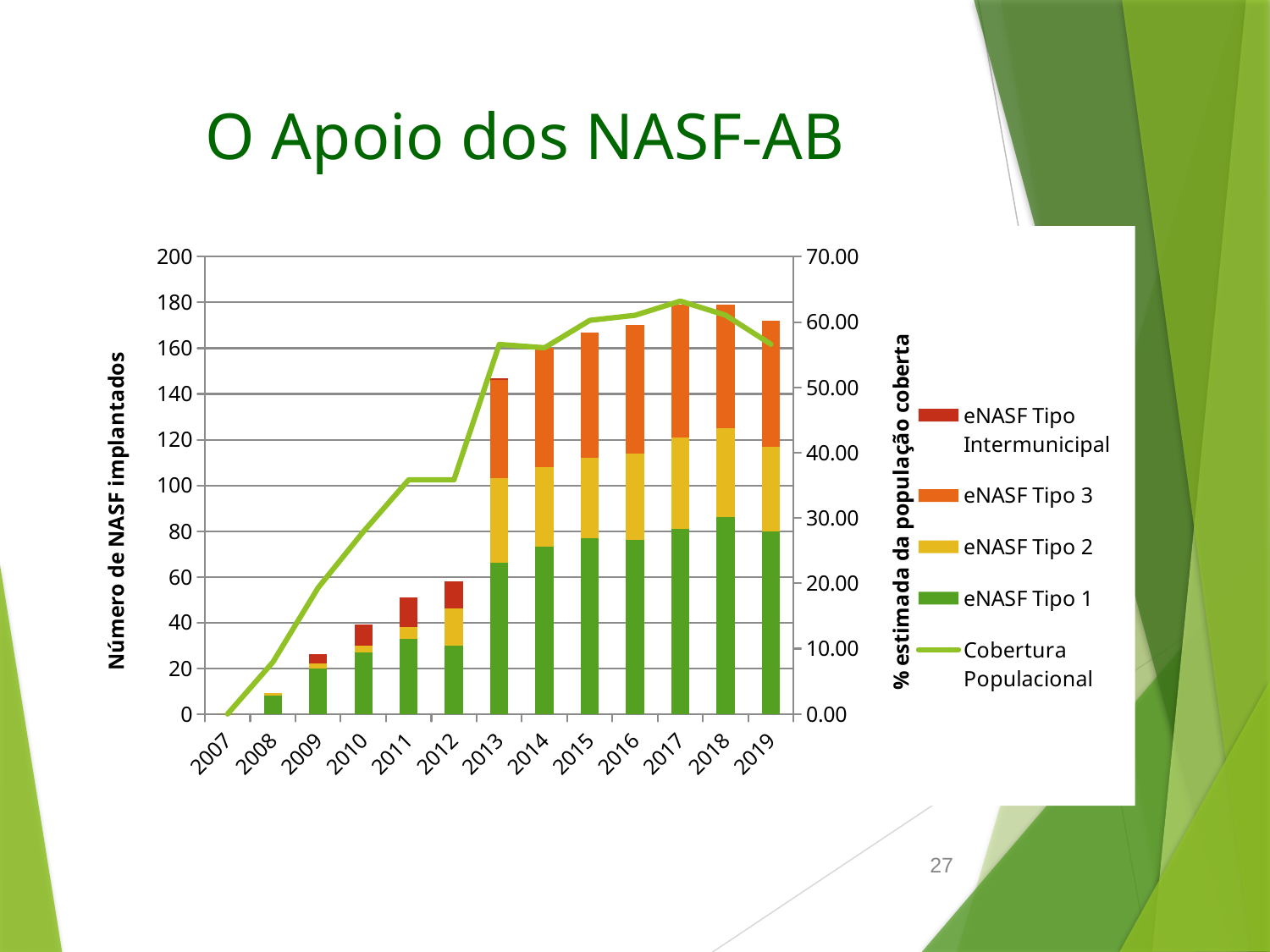
What kind of chart is shown on the slide? Stacked bar chart with a line What is the label of the left vertical axis? Número de NASF implantados Is the total stacked bar for 2013 greater or less than 140? greater Is the Cobertura Populacional value for 2011 greater or less than 30.00? greater In which year does the Cobertura Populacional line reach its highest point? 2017 How many series does the chart legend list? 5 Which year has the larger total stacked bar, 2017 or 2019? 2017 Is the Cobertura Populacional value for 2019 greater or less than 50.00? greater How many years are shown on the x axis of the chart? 13 Does the Cobertura Populacional line rise or fall from 2007 to 2017? rise